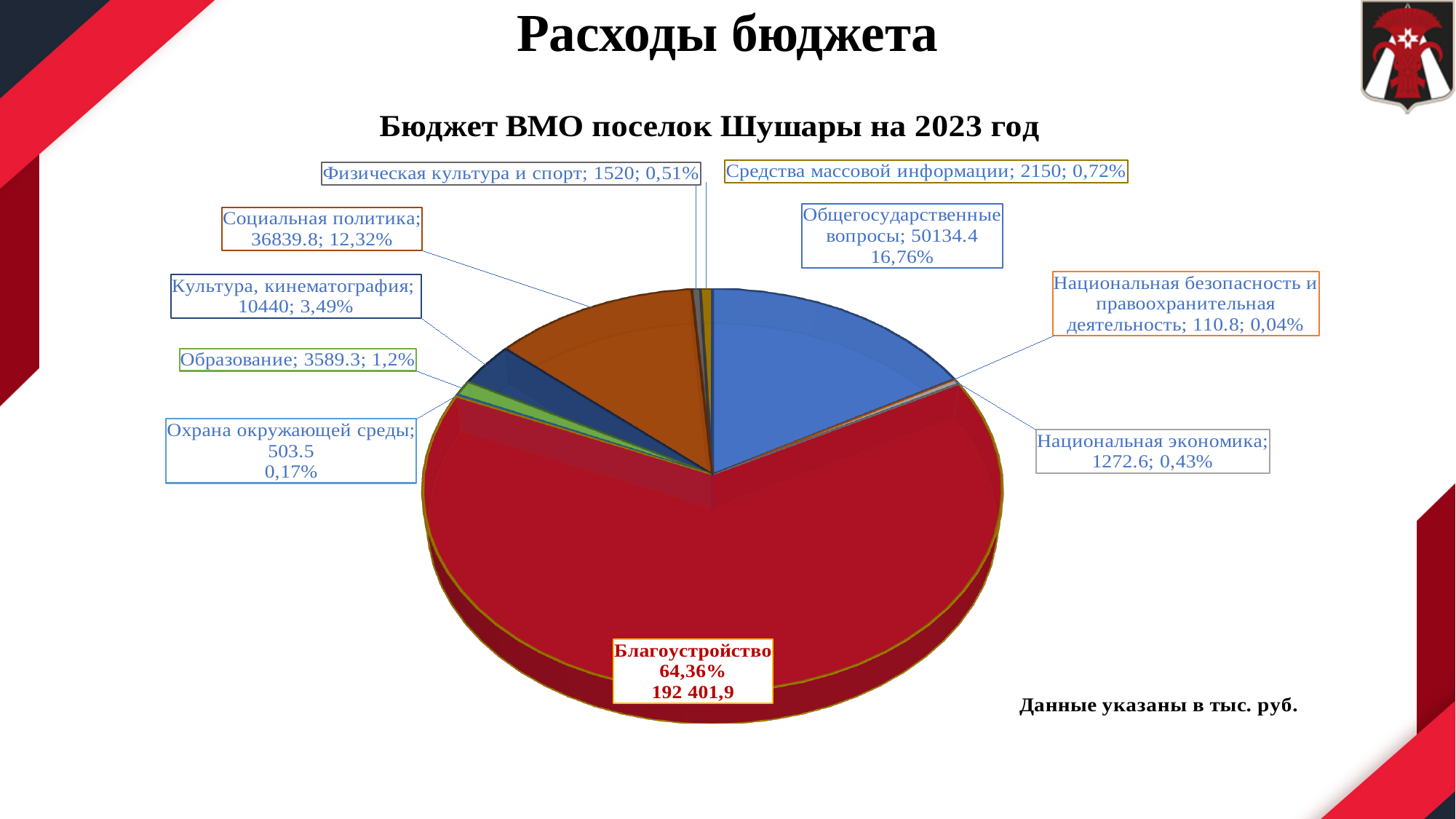
What is the difference between the values for Образование and Национальная экономика? 2316.7 What is the title of the chart? Бюджет ВМО поселок Шушары на 2023 год What share of the pie does Общегосударственные вопросы take? 16,76% Which is larger, the value for Средства массовой информации or the value for Физическая культура и спорт? Средства массовой информации How many categories does the pie chart show? 10 Which category has the largest share of the pie? Благоустройство What is the value for Охрана окружающей среды? 503.5 What is the value for Благоустройство? 192 401,9 What kind of chart is shown on the slide? pie chart What share of the pie does Культура, кинематография take? 3,49% Which category has the smallest share of the pie? Национальная безопасность и правоохранительная деятельность What is the value for Социальная политика? 36839.8